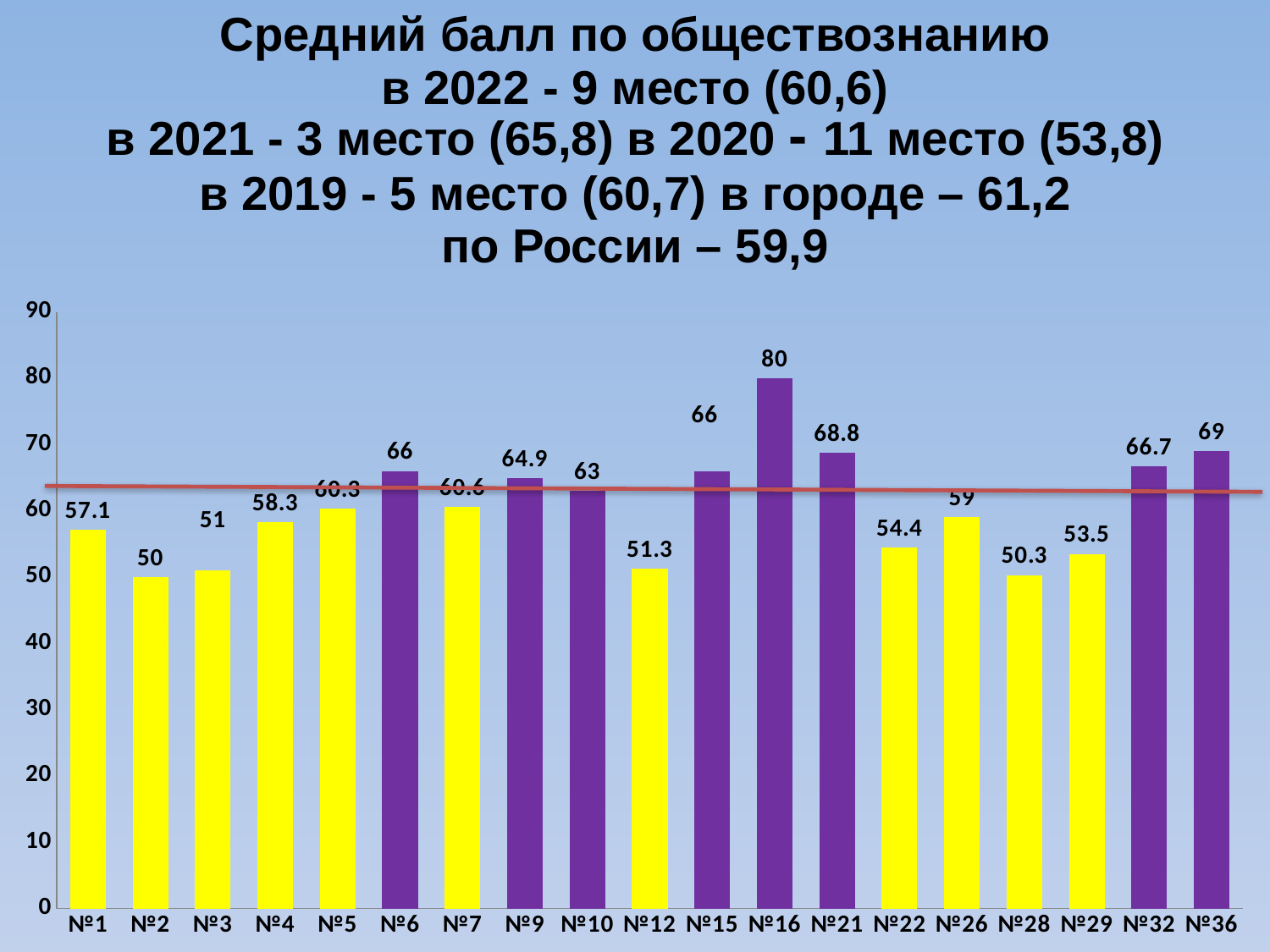
What is the difference between the values for №16 and №2? 30 How many categories are shown on the x axis? 19 Which category has the highest value? №16 Is the value for №12 greater or less than 60? less What is the value for №1? 57.1 What is the value for №16? 80 What is the value for №29? 53.5 Which category has the lowest value? №2 Which has a larger value, №21 or №32? №21 What colour is the bar for №16? purple What kind of chart is shown on the slide? bar chart What is the difference between the values for №36 and №32? 2.3